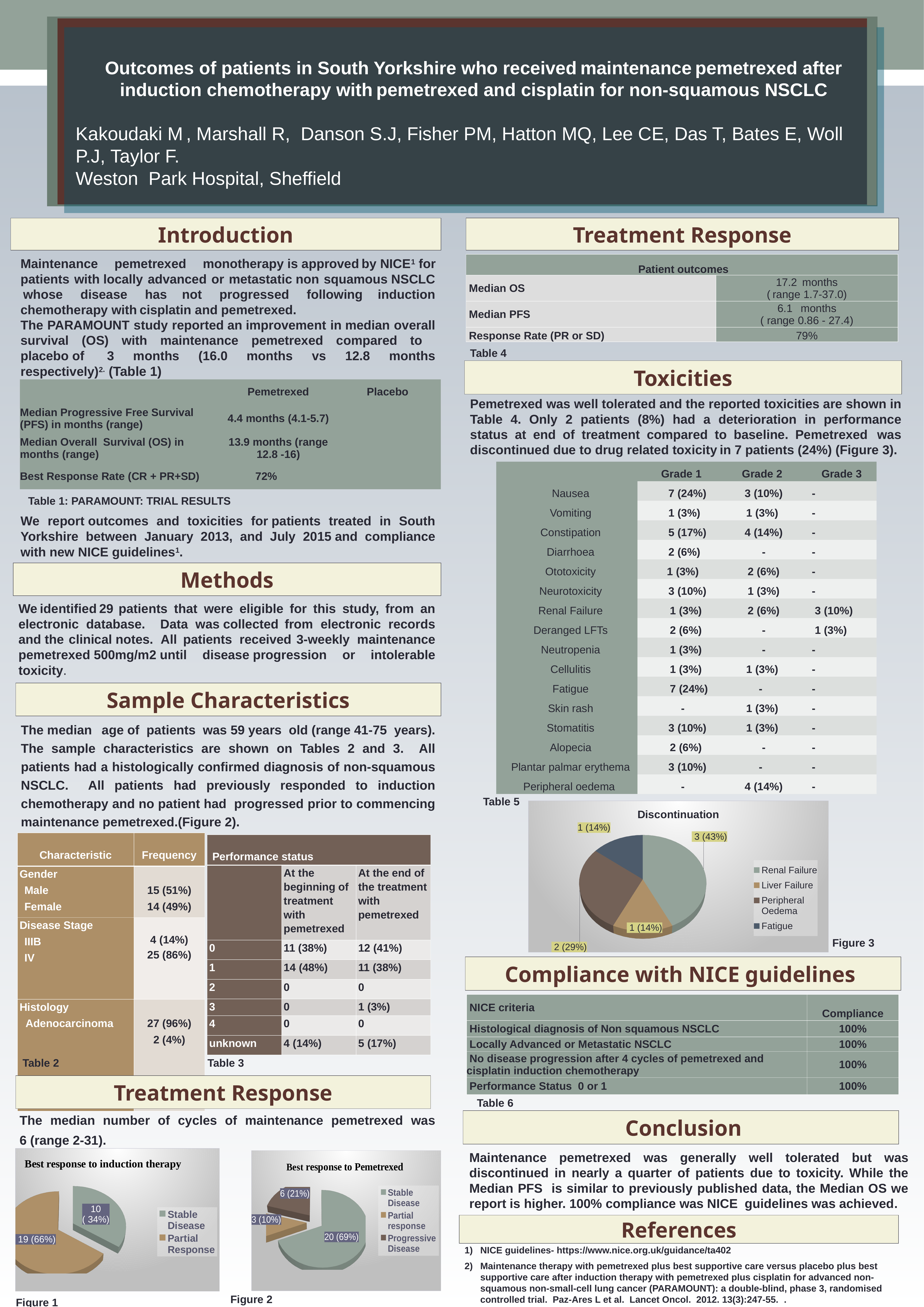
In the 'Best response to induction therapy' pie chart, how many categories does the legend list? 2 In the 'Best response to Pemetrexed' pie chart, how many categories does the legend list? 3 In the 'Best response to Pemetrexed' pie chart, which category has the smallest share? Partial response In the 'Best response to induction therapy' pie chart, which category has the larger share? Partial Response In the 'Best response to Pemetrexed' pie chart, what value is shown for Progressive Disease? 6 (21%) In the 'Best response to induction therapy' pie chart, what value is shown for Partial Response? 19 (66%) In the 'Discontinuation' pie chart, how many categories does the legend list? 4 In the 'Discontinuation' pie chart, what value is shown for the largest slice, Renal Failure? 3 (43%) In the 'Best response to Pemetrexed' pie chart, how many more patients had Stable Disease than Progressive Disease? 14 In the 'Best response to Pemetrexed' pie chart, what value is shown for Stable Disease? 20 (69%) In the 'Best response to induction therapy' pie chart, what value is shown for Stable Disease? 10 (34%) What type of chart is Figure 3 ('Discontinuation')? Pie chart